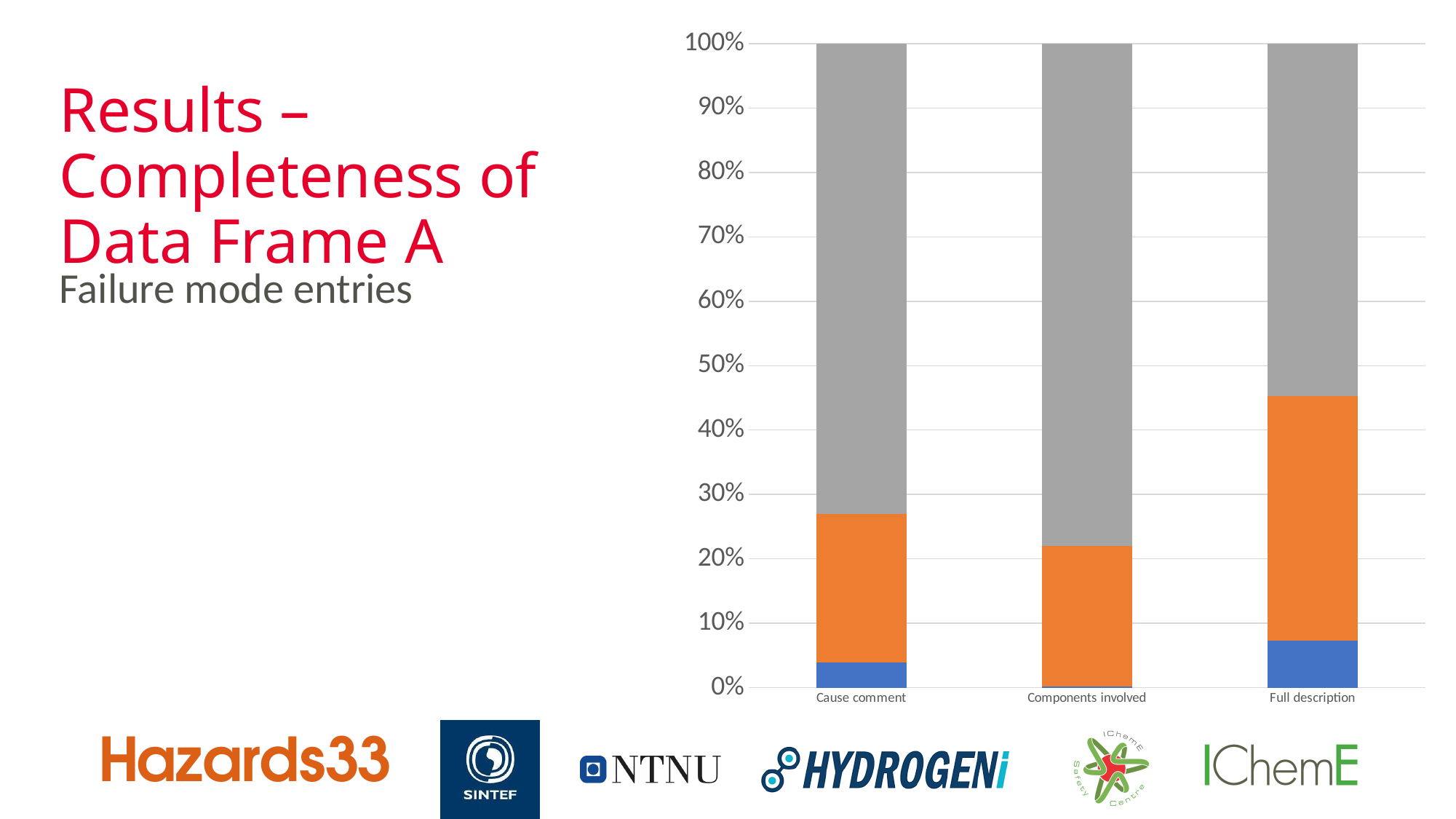
Is the blue segment for Full description greater or less than 10%? less What is the subtitle printed under the slide title, describing what the chart shows? Failure mode entries Which category has the smallest grey segment in its bar? Full description Which category has the largest orange segment in its bar? Full description How many categories are shown on the x axis of the chart? 3 Is the top of the orange segment for Full description greater or less than 40%? greater Is the top of the orange segment for Components involved greater or less than 30%? less Is the orange segment larger for Full description or for Cause comment? Full description What are the three categories on the x axis of the chart? Cause comment, Components involved, Full description Is the blue segment larger for Full description or for Cause comment? Full description What kind of chart is shown on the slide? Stacked bar chart